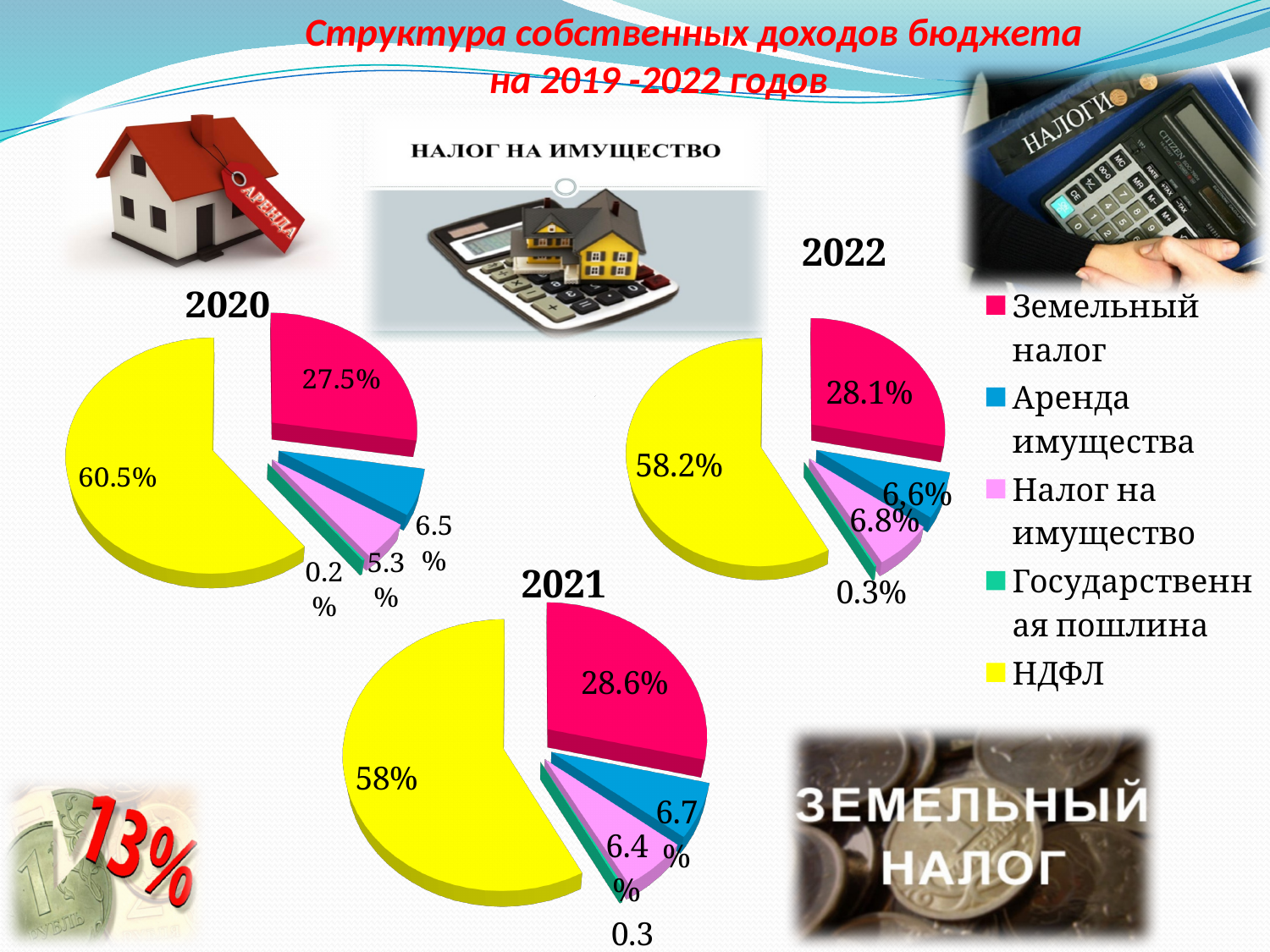
What colour represents НДФЛ in the pie charts? yellow What kind of chart is used for the 2020 data on the slide? pie chart In the 2020 pie chart, what share does НДФЛ have? 60.5% In the 2022 pie chart, what is the value for Земельный налог? 28.1% In the 2021 pie chart, what is the value for НДФЛ? 58% In the 2020 pie chart, what is the value for Земельный налог? 27.5% In the 2020 pie chart, which category has the smallest share? Государственная пошлина In the 2021 pie chart, which is larger: Земельный налог or Аренда имущества? Земельный налог How many categories does the legend list? 5 In the 2022 pie chart, what is the value for НДФЛ? 58.2% In the 2020 pie chart, what is the difference between the НДФЛ share and the Земельный налог share? 33% In the 2021 pie chart, which category has the largest share? НДФЛ